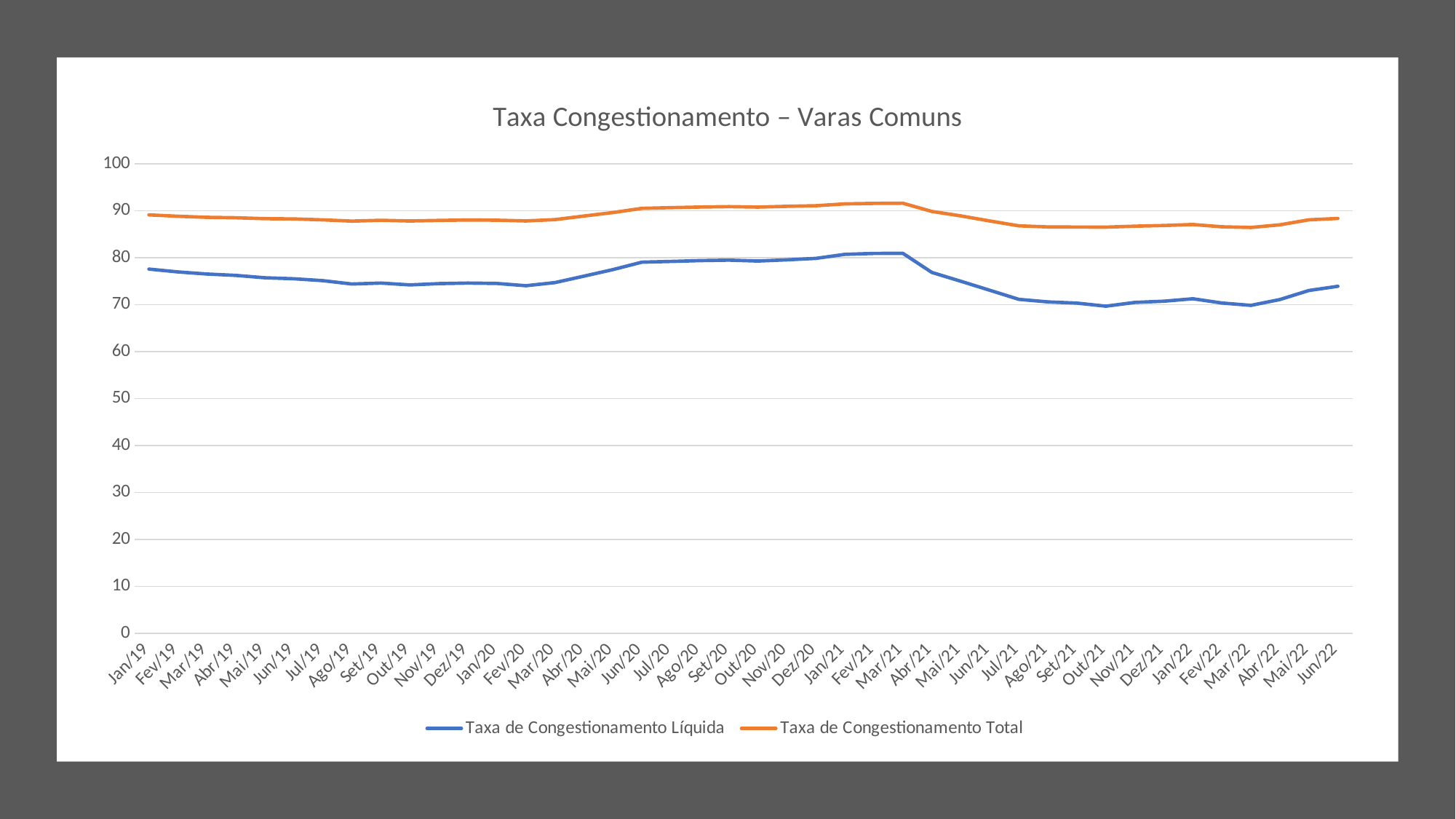
Is the value of Taxa de Congestionamento Líquida for Jan/19 greater or less than 70? greater What is the title of the chart? Taxa Congestionamento – Varas Comuns In Jun/22, which series has the higher value, Taxa de Congestionamento Líquida or Taxa de Congestionamento Total? Taxa de Congestionamento Total Does the Taxa de Congestionamento Líquida line rise or fall between Mar/21 and Jul/21? fall Is the value of Taxa de Congestionamento Total for Mar/21 greater or less than 90? greater Which series is drawn in orange? Taxa de Congestionamento Total How many series does the legend list? 2 What kind of chart is shown on the slide? line chart Is the value of Taxa de Congestionamento Total for Ago/21 greater or less than 90? less Does the Taxa de Congestionamento Líquida line rise or fall between Mar/20 and Jun/20? rise How many monthly points are plotted along the x axis, from Jan/19 to Jun/22? 42